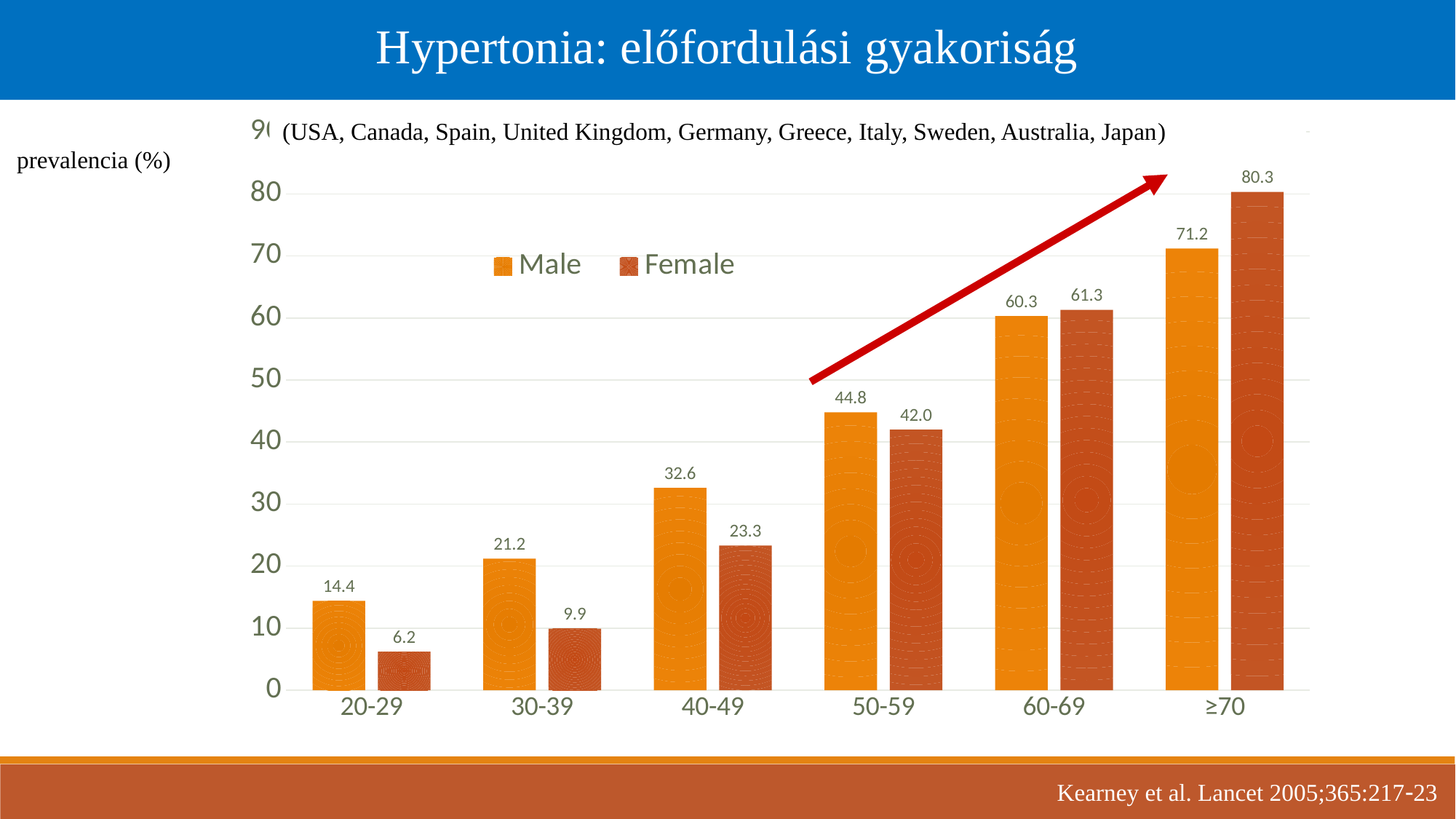
What is the Female value for the 20-29 age group? 6.2 What is the difference between the Female values for the ≥70 and 60-69 age groups? 19.0 What kind of chart is shown on the slide? bar chart Which is larger for the 30-39 age group, the Male or the Female value? Male What is the Female value for the ≥70 age group? 80.3 What is the difference between the Male and Female values for the 50-59 age group? 2.8 Which age group has the lowest Female value? 20-29 How many age groups are shown on the x axis? 6 Do the Male values rise or fall as age increases along the x axis? rise How many series does the legend list? 2 Which age group has the highest Male value? ≥70 What is the Male value for the 40-49 age group? 32.6